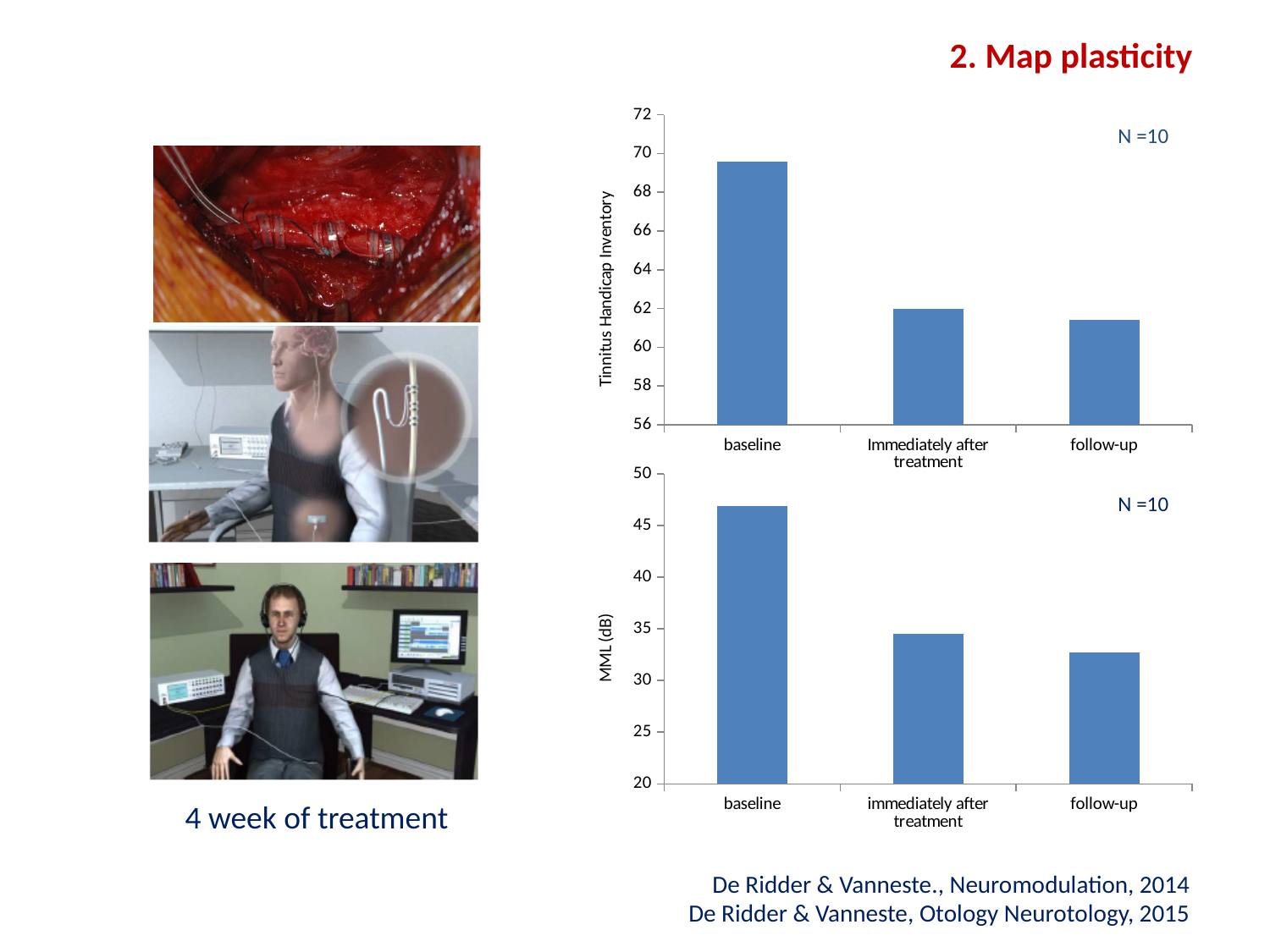
In the top chart (Tinnitus Handicap Inventory), is the value for follow-up greater or less than 62? less In the bottom chart (MML (dB)), which is larger: the value for immediately after treatment or the value for follow-up? immediately after treatment In the top chart (Tinnitus Handicap Inventory), do the values rise or fall from baseline to follow-up? fall In the bottom chart (MML (dB)), which category has the highest value? baseline What sample size (N) is shown on the bottom chart (MML (dB))? N =10 In the top chart (Tinnitus Handicap Inventory), which category has the lowest value? follow-up In the bottom chart (MML (dB)), is the value for baseline greater or less than 45? greater How many categories are shown on the x axis of the top chart (Tinnitus Handicap Inventory)? 3 In the bottom chart (MML (dB)), which category has the lowest value? follow-up In the top chart (Tinnitus Handicap Inventory), which category has the highest value? baseline What type of chart is the top chart on the slide (y-axis 'Tinnitus Handicap Inventory')? bar chart In the top chart (Tinnitus Handicap Inventory), is the value for baseline greater or less than 68? greater